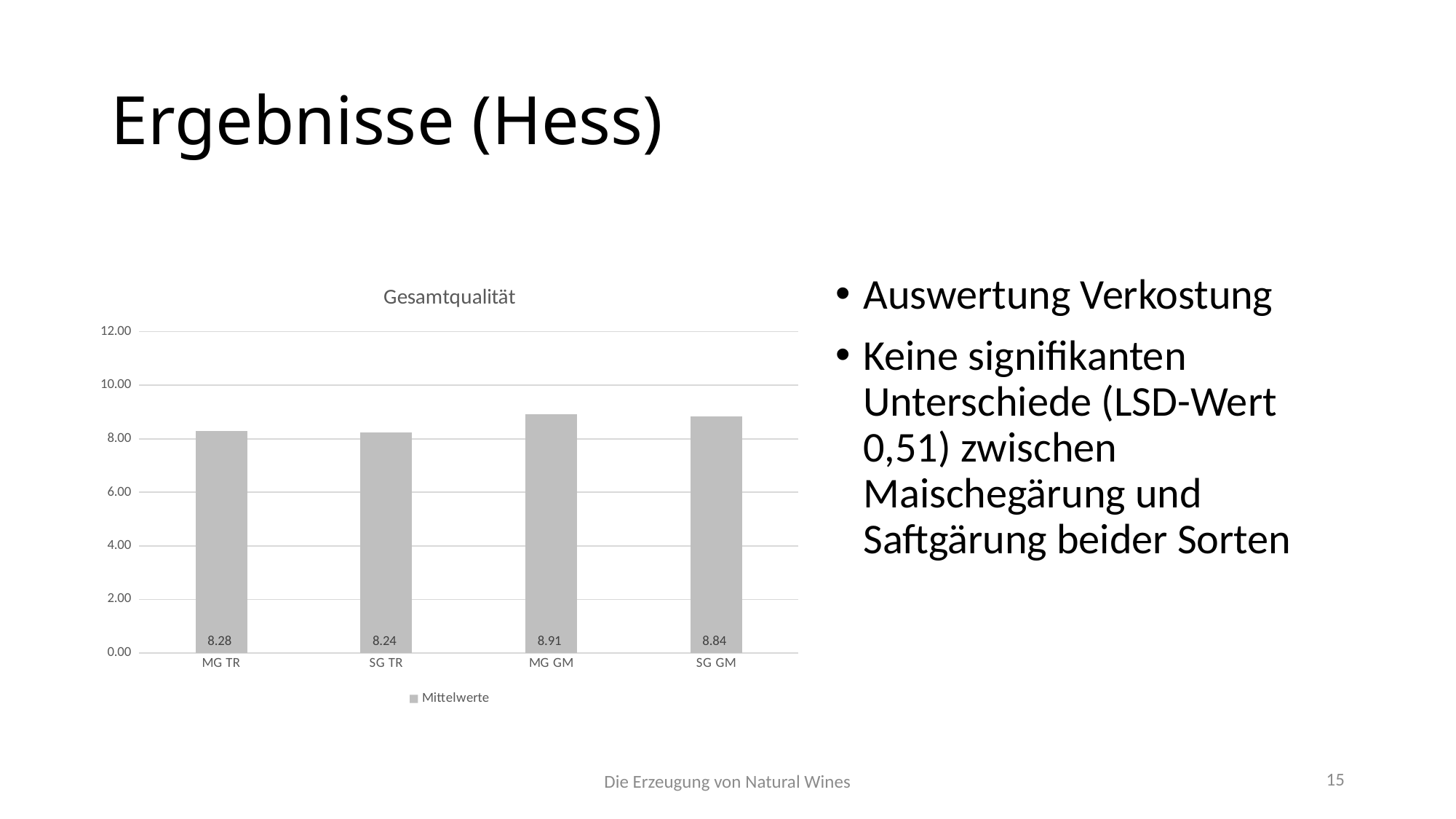
Is the value for SG GM greater or less than 10.00? less How many categories are shown on the x axis? 4 What kind of chart is shown? bar chart Which is larger, the value for MG GM or the value for SG GM? MG GM What is the value for MG GM? 8.91 What is the title of the chart? Gesamtqualität Which category has the lowest value? SG TR What is the value for MG TR? 8.28 What is the value for SG TR? 8.24 What is the difference between the values for MG GM and MG TR? 0.63 What is the value for SG GM? 8.84 Which category has the highest value? MG GM